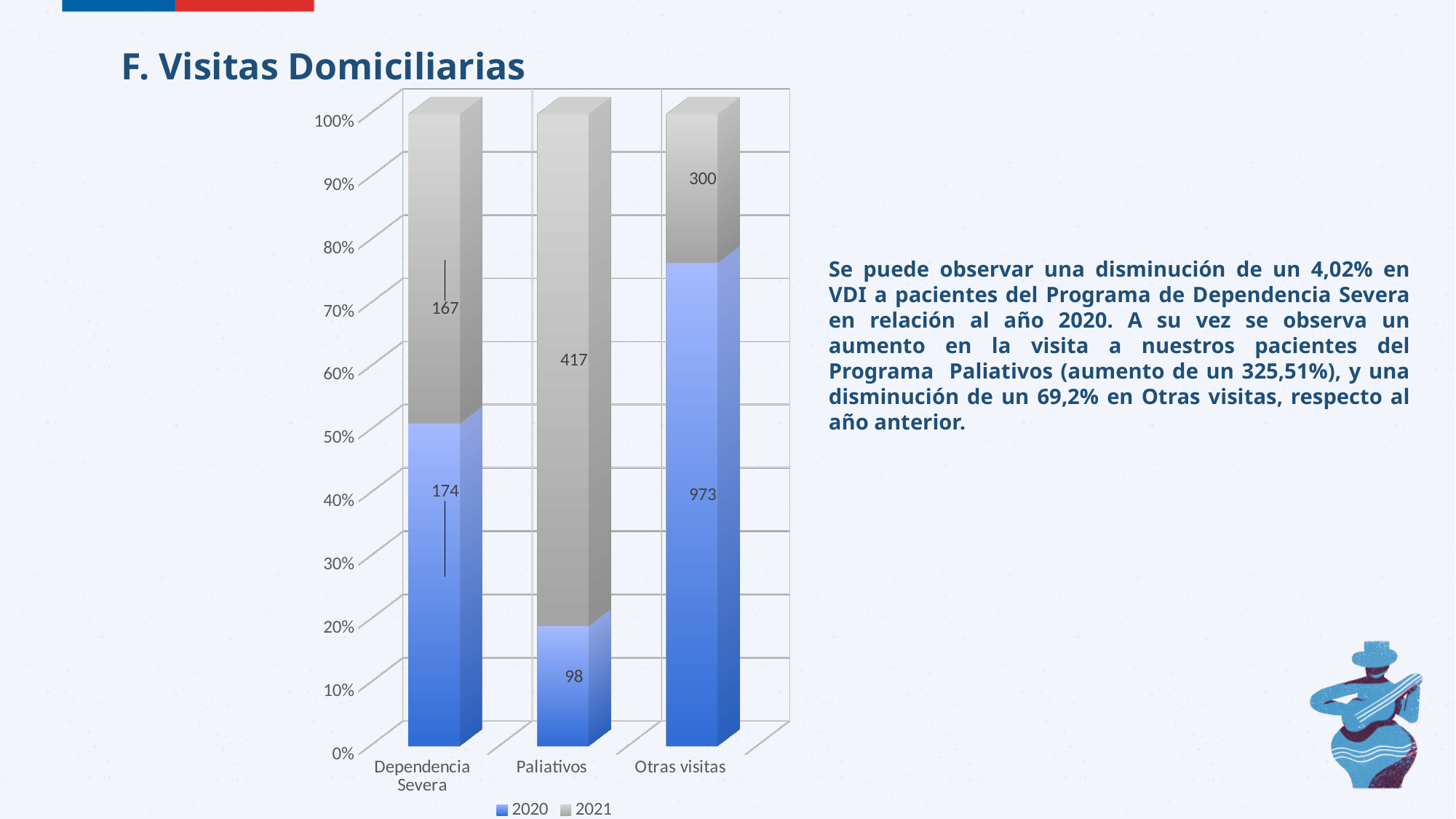
Which category has the highest value for the 2020 series? Otras visitas Which category has the lowest value for the 2020 series? Paliativos What is the total of the 2020 and 2021 values for Dependencia Severa? 341 Which is larger for Otras visitas: the 2020 value or the 2021 value? 2020 What is the value for 2021 in the Otras visitas category? 300 What is the value for 2020 in the Dependencia Severa category? 174 What kind of chart is shown on the slide? Stacked bar chart What is the value for 2020 in the Otras visitas category? 973 What is the value for 2021 in the Paliativos category? 417 What is the difference between the 2021 and 2020 values for Paliativos? 319 How many categories are shown on the x axis? 3 How many series does the legend list? 2